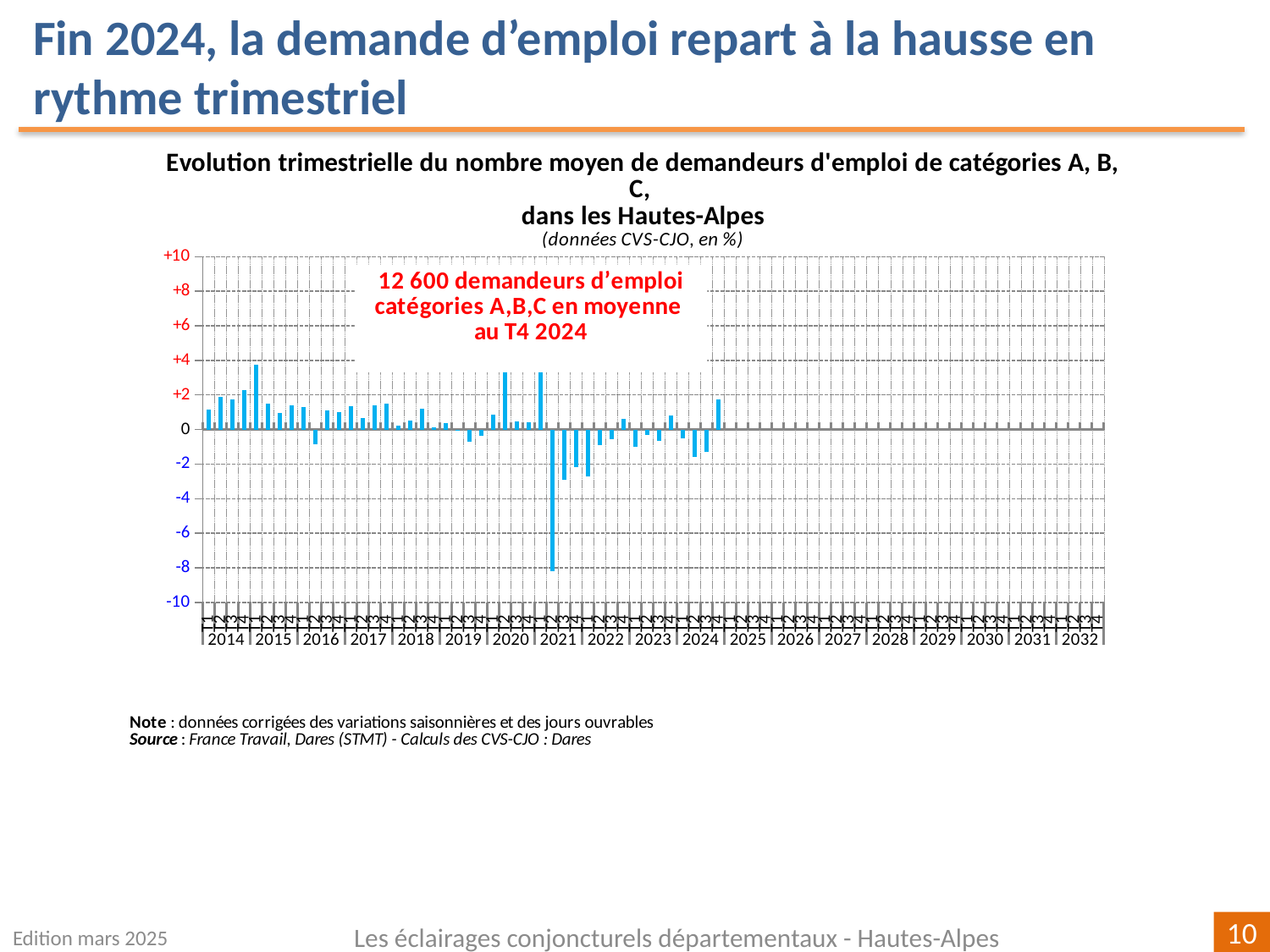
Is the lowest bar of the chart (in 2021) greater or less than -6? less According to the red annotation on the chart, how many demandeurs d'emploi catégories A,B,C were there on average in T4 2024? 12 600 Which is larger: the lowest bar in 2021 or the lowest bar in 2022? the lowest bar in 2022 Is the negative bar in 2016 greater or less than -2? greater Is the last plotted bar (end of 2024) greater or less than 0? greater In which year does the lowest bar of the chart appear? 2021 What type of chart is shown on the slide? bar chart In what unit are the values of the chart expressed, according to the subtitle? %